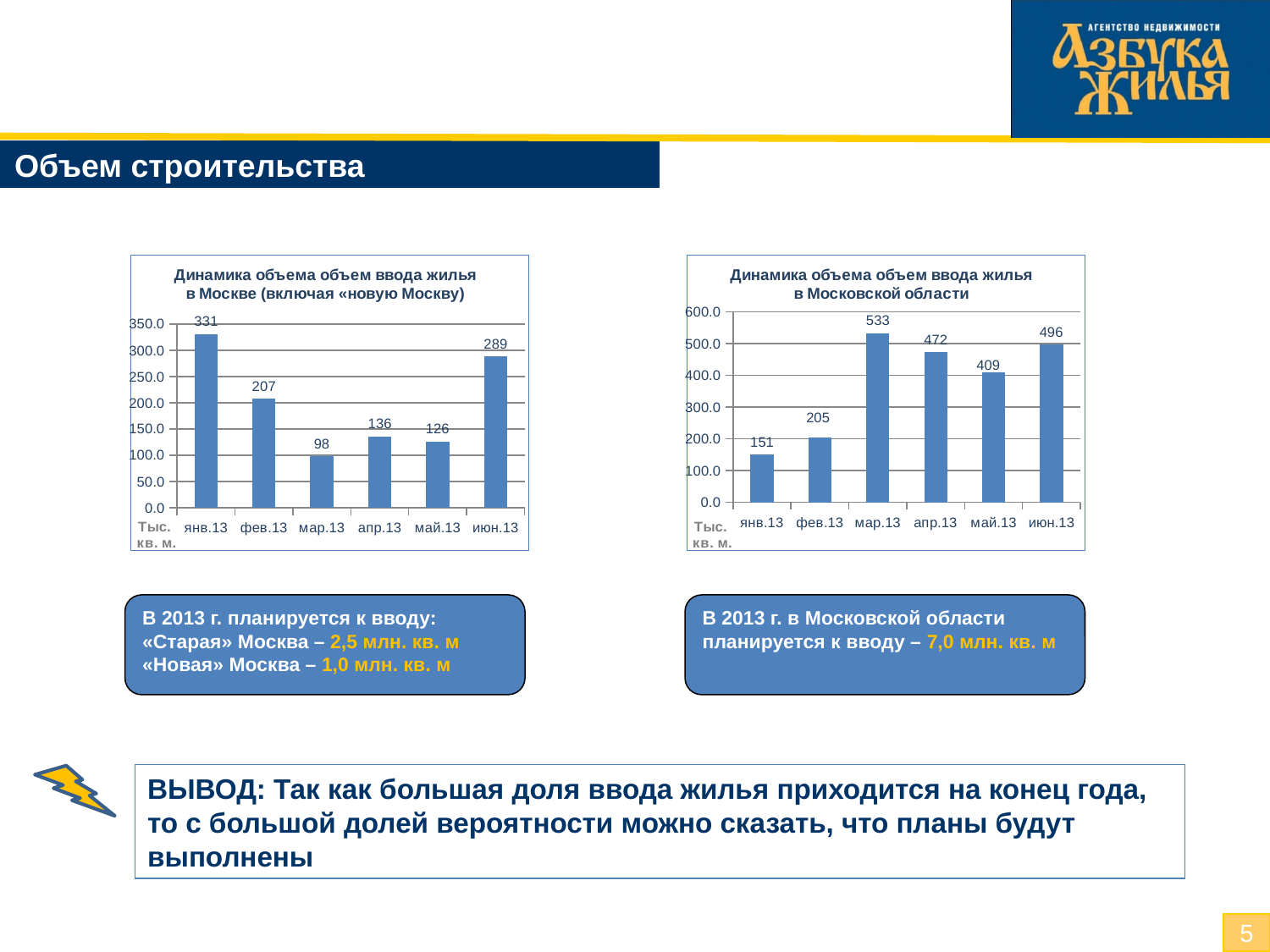
How many months are shown in the left chart (Москва)? 6 In the right chart (Московская область), which month has the lowest value? янв.13 What is the title of the left chart? Динамика объема объем ввода жилья в Москве (включая «новую Москву) In the left chart (Москва), which is larger, the value for апр.13 or май.13? апр.13 In the right chart (Московская область), what is the difference between the values for мар.13 and апр.13? 61 In the right chart (Московская область), is the value for фев.13 greater or less than 300.0? less In the right chart (Московская область), what is the value for мар.13? 533 In the right chart (Московская область), which month has the highest value? мар.13 In the left chart (Москва), which month has the lowest value? мар.13 What type of chart is the right chart (Московская область)? bar chart In the left chart (Москва), what is the value for янв.13? 331 In the left chart (Москва), what is the difference between the values for янв.13 and июн.13? 42